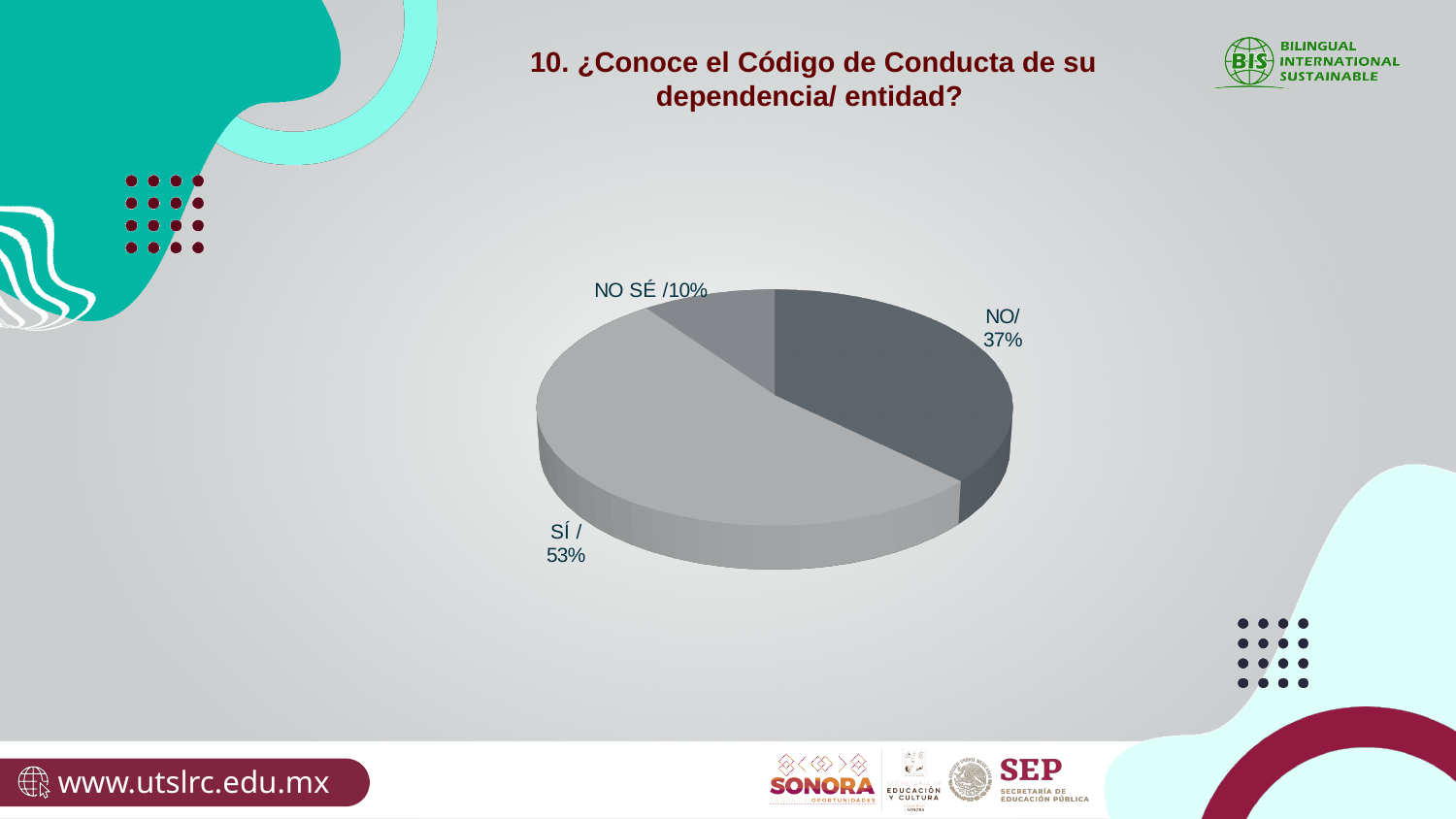
How many slices does the pie chart have? 3 What percentage of respondents answered SÍ? 53% What is the difference in percentage points between the SÍ and NO slices? 16 What kind of chart is shown on the slide? pie chart What percentage of respondents answered NO SÉ? 10% What is the difference in percentage points between the NO and NO SÉ slices? 27 What is the title of the chart? 10. ¿Conoce el Código de Conducta de su dependencia/ entidad? What percentage of respondents answered NO? 37% Which response has the largest share of the pie? SÍ What share of the pie does the SÍ slice represent? 53% Which is larger, the NO slice or the NO SÉ slice? NO Which response has the smallest share of the pie? NO SÉ